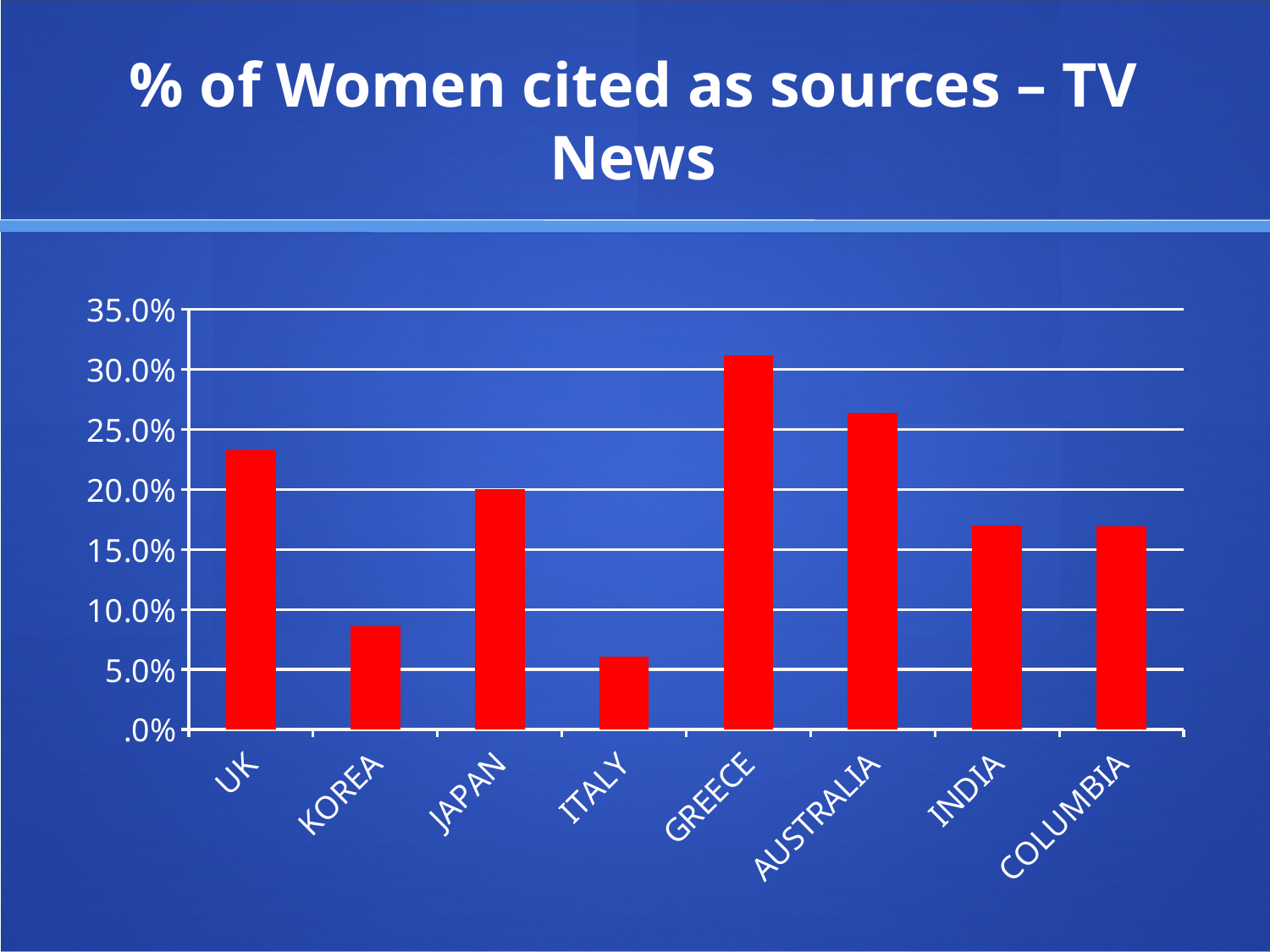
Which country has the highest percentage of women cited as sources? GREECE Which has a larger value, KOREA or JAPAN? JAPAN Which country has the lowest percentage of women cited as sources? ITALY Which has a larger value, GREECE or AUSTRALIA? GREECE What is the title of the chart? % of Women cited as sources – TV News Is the value for GREECE greater or less than 30.0%? greater Is the value for UK greater or less than 20.0%? greater What kind of chart is shown on the slide? bar chart Is the value for KOREA greater or less than 10.0%? less How many countries are shown on the x axis of the chart? 8